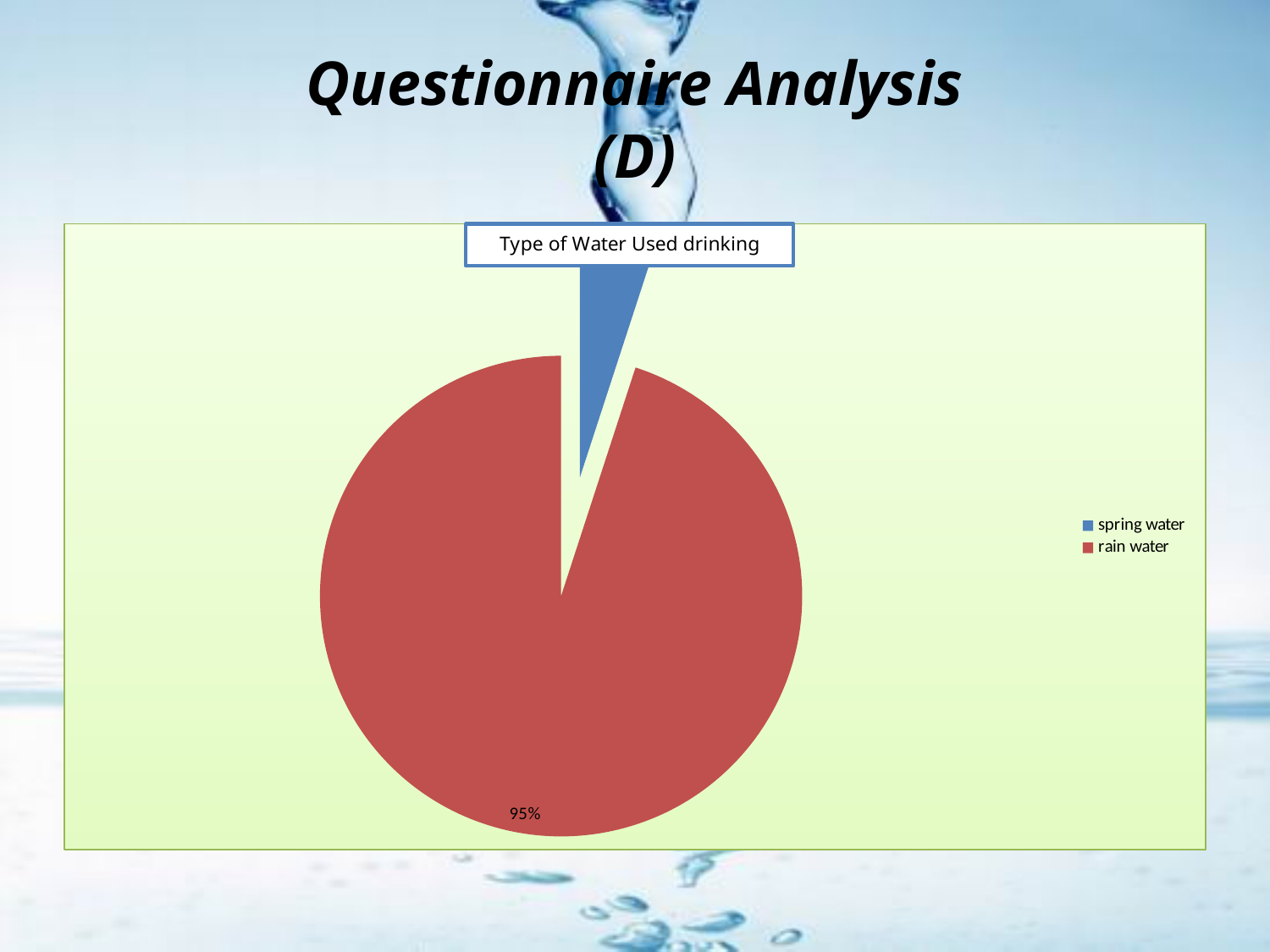
What is the title of the chart? Type of Water Used drinking Which category has the largest slice of the pie? rain water How many entries does the legend list? 2 How many categories are shown in the pie chart? 2 What share of the pie does rain water account for? 95% What colour is the slice for spring water? blue Which is larger, the slice for spring water or the slice for rain water? rain water What kind of chart is shown on the slide? pie chart Is the share for rain water greater or less than 50%? greater Which category has the smallest slice of the pie? spring water